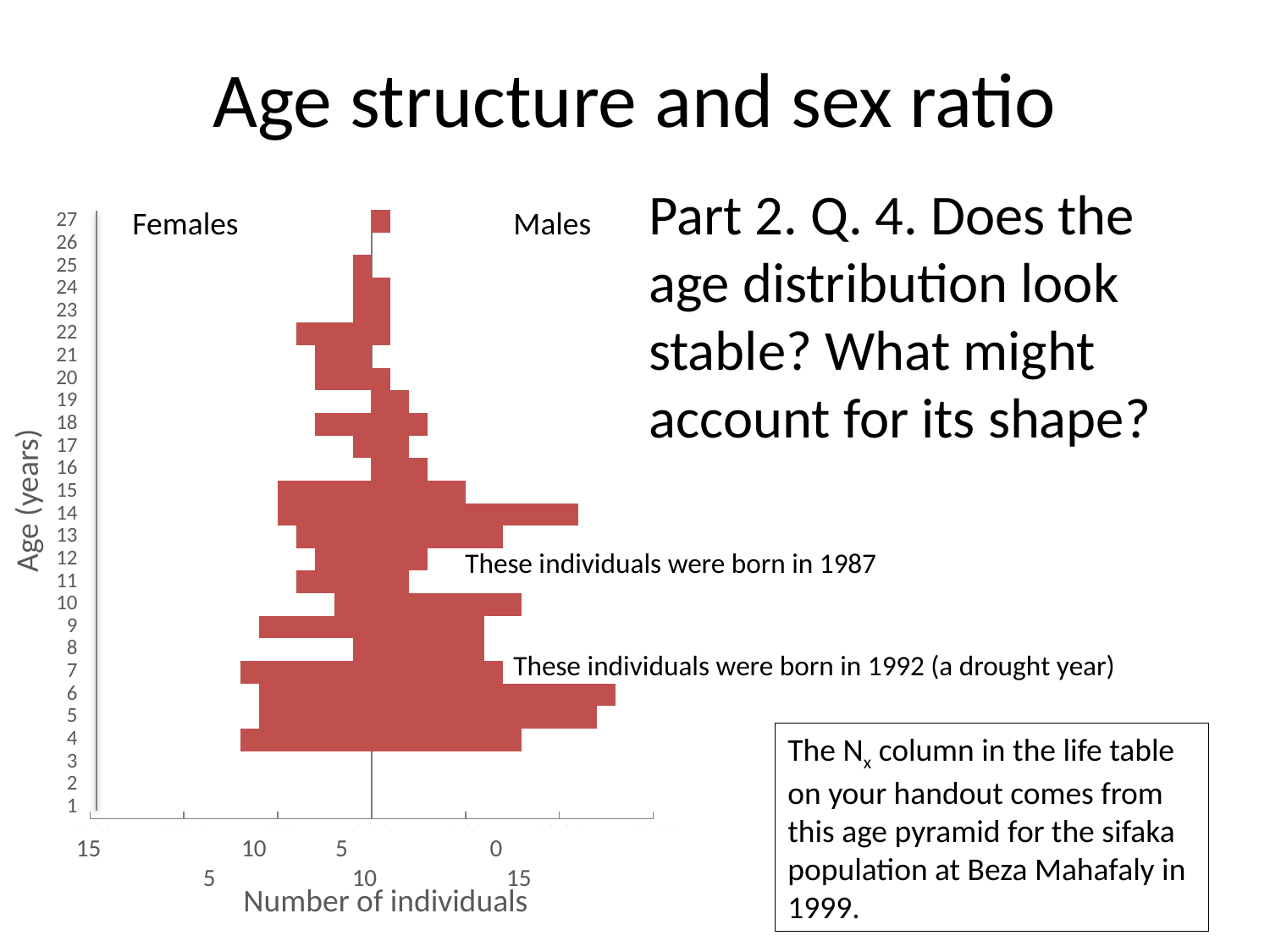
What is the label of the horizontal axis of the age pyramid? Number of individuals Which is larger, the number of males aged 6 or the number of males aged 10? Males aged 6 Is the number of females aged 7 greater or less than 10? less Which sex is plotted on the left side of the age pyramid? Females Is the number of females aged 7 greater or less than 5? greater How many age classes are listed on the vertical axis of the age pyramid? 27 At which age is the number of males highest? 6 Is the number of males aged 6 greater or less than 10? greater What kind of chart is shown on the slide? Bar chart (age pyramid) Which is larger, the number of males aged 14 or the number of females aged 14? Males aged 14 Which is larger, the number of females aged 9 or the number of females aged 12? Females aged 9